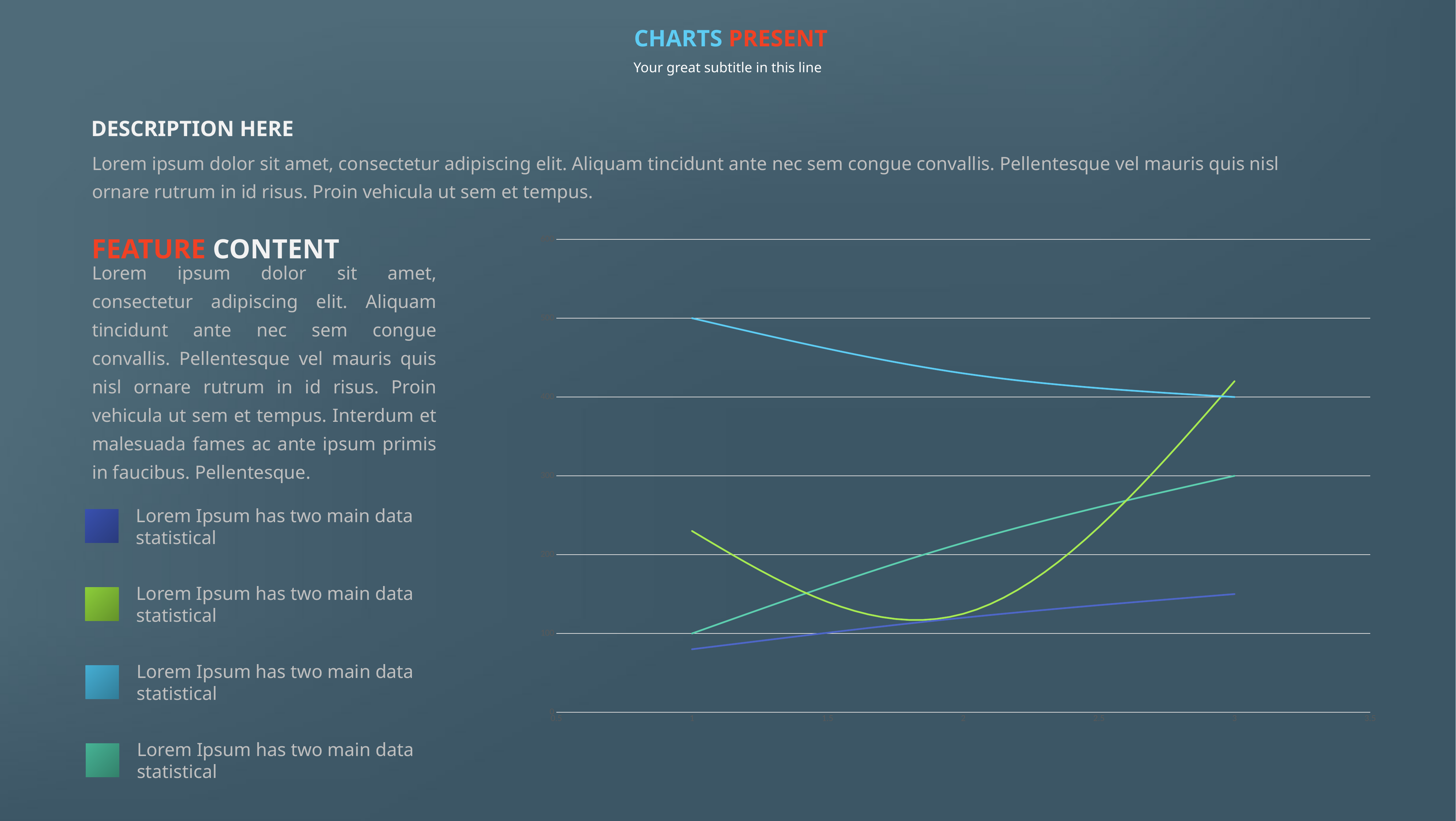
Which line is the highest at the left end of the chart? the light blue (cyan) line How many lines are plotted on the chart? 4 What is the title shown at the top of the slide? CHARTS PRESENT Which line is the lowest at the right end of the chart? the dark blue line Which line reaches the highest point at the right end of the chart? the bright green line What kind of chart is shown on the slide? line chart Does the light blue (cyan) line rise or fall from left to right? fall Does the dark blue line rise or fall from left to right? rise At the right end of the chart, which is higher: the bright green line or the light blue (cyan) line? the bright green line Does the teal (green-blue) line rise or fall from left to right? rise Which line is the lowest at the left end of the chart? the dark blue line How many coloured legend squares are listed on the left side of the slide? 4